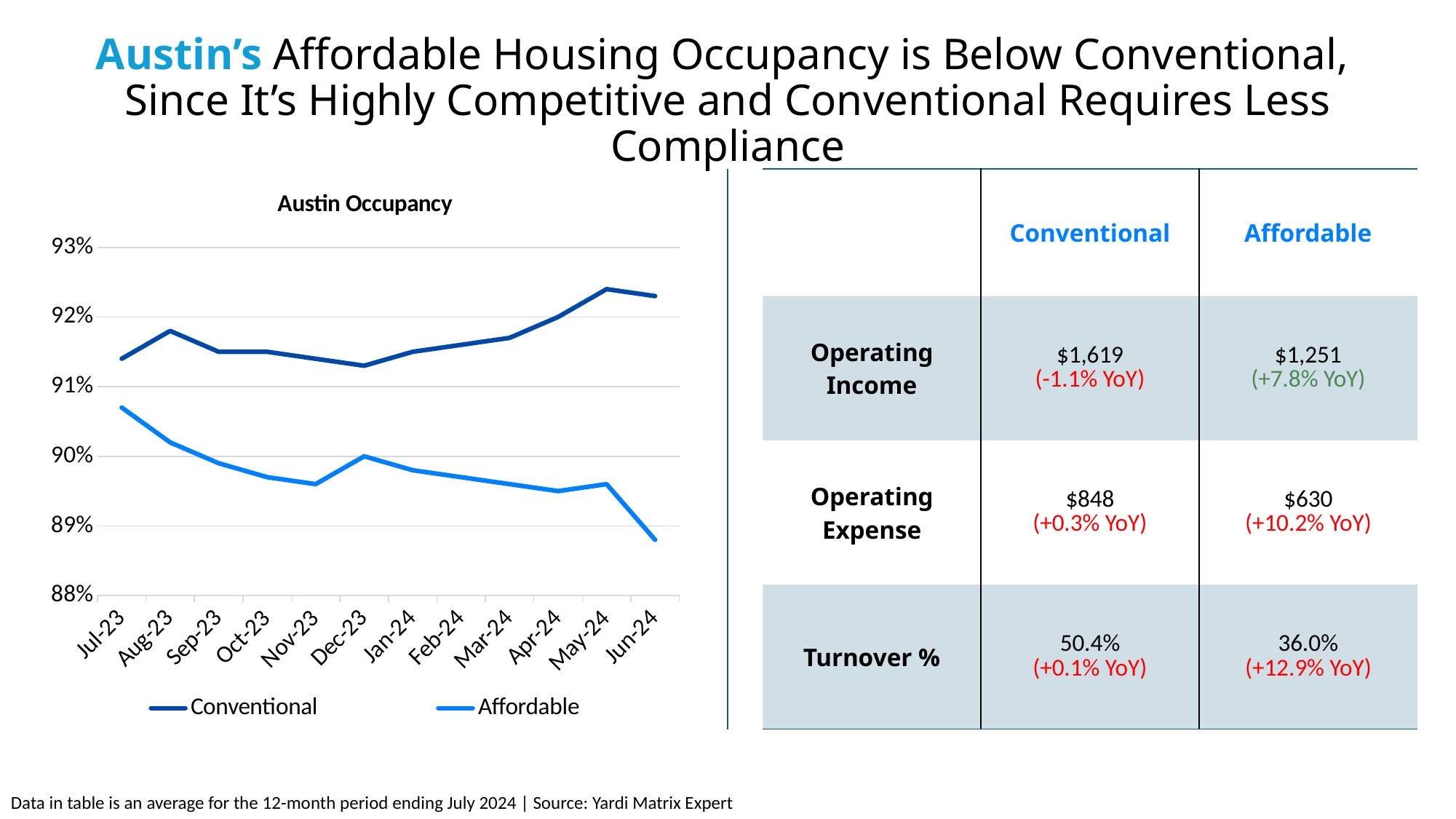
In the Austin Occupancy chart, is the Affordable value for Apr-24 greater or less than 90%? less What kind of chart is the Austin Occupancy chart? line chart In the Austin Occupancy chart, is the Conventional value for Jul-23 greater or less than 91%? greater How many months are plotted along the x axis of the Austin Occupancy chart? 12 How many series does the legend of the Austin Occupancy chart list? 2 In the Austin Occupancy chart, does the Affordable series overall rise or fall from Jul-23 to Jun-24? fall In the Austin Occupancy chart, is the Affordable value for Jul-23 greater or less than 90%? greater In the Austin Occupancy chart, which month has the lowest Affordable occupancy? Jun-24 In the Austin Occupancy chart, which series is higher in Jul-23, Conventional or Affordable? Conventional In the Austin Occupancy chart, which month has the highest Conventional occupancy? May-24